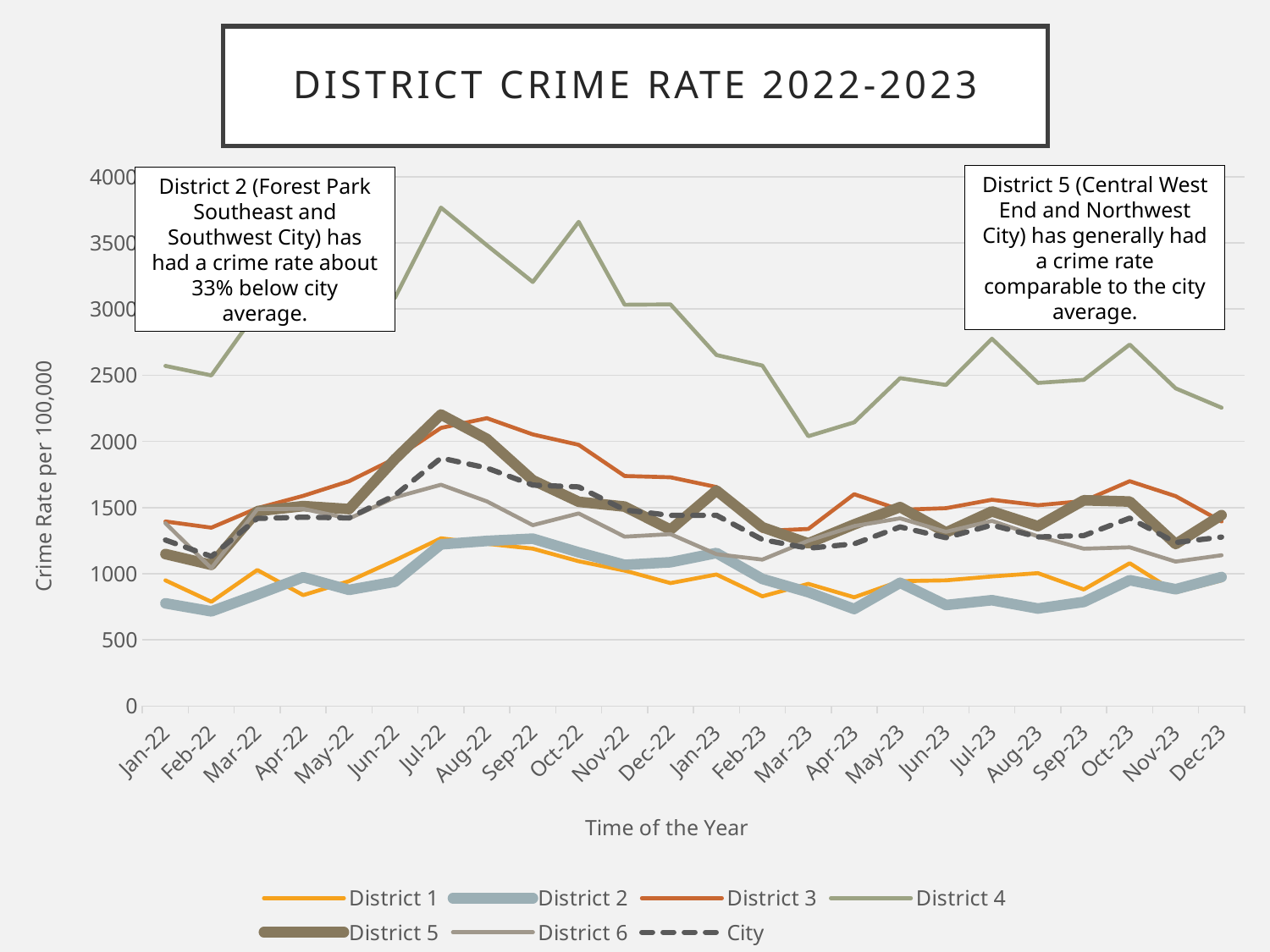
Is the value for District 4 in Jul-22 greater or less than 3500? greater Which series has the highest value in Jul-22? District 4 Which is higher in Jan-22, District 4 or District 3? District 4 What is the title of the chart? DISTRICT CRIME RATE 2022-2023 How many series does the legend list? 7 How many months are plotted along the x axis? 24 Which series has the lowest value in Jan-22? District 2 Is the value for District 2 in Jan-22 greater or less than 1000? less Is the value for District 4 in Mar-23 greater or less than 2500? less Does the District 4 line rise or fall from Jul-22 to Mar-23? fall Which series is drawn with a dashed line? City What kind of chart is shown on the slide? line chart